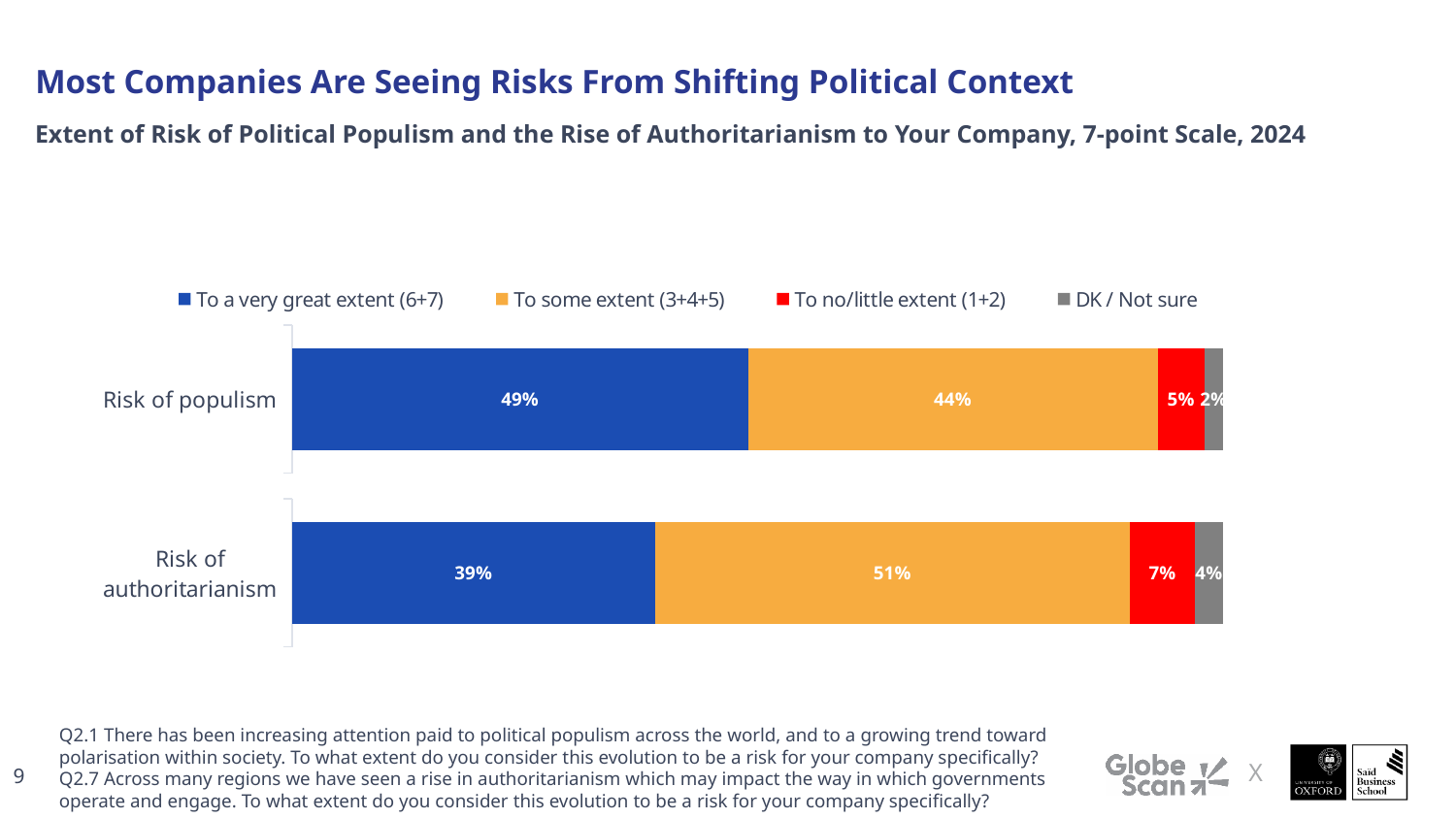
What kind of chart is shown on the slide? Stacked bar chart Which category has the higher 'To a very great extent (6+7)' value, risk of populism or risk of authoritarianism? Risk of populism What percentage of respondents see risk of authoritarianism to some extent (3+4+5)? 51% What is the difference between the 'To a very great extent (6+7)' values for risk of populism and risk of authoritarianism? 10 percentage points What percentage of respondents see risk of populism to a very great extent (6+7)? 49% How many series does the legend list? 4 Which colour represents 'To no/little extent (1+2)' in the legend? Red What is the total of the stacked bar for risk of authoritarianism? 101% What is the 'DK / Not sure' value for risk of populism? 2% How many categories are shown on the chart? 2 What is the 'To no/little extent (1+2)' value for risk of authoritarianism? 7% What is the difference between the 'To some extent (3+4+5)' values for risk of authoritarianism and risk of populism? 7 percentage points